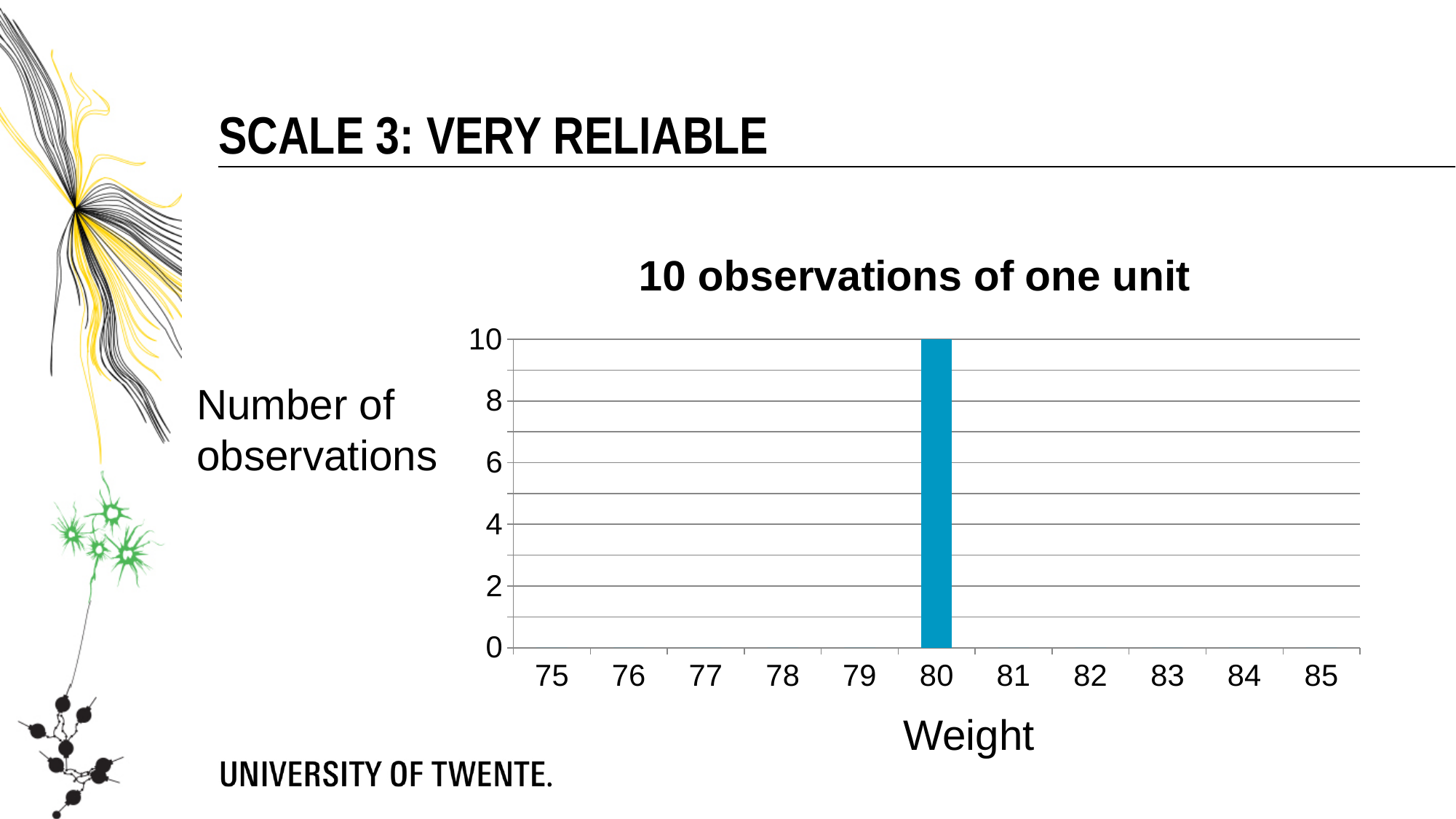
What is the difference between the number of observations at weight 80 and at weight 75? 10 Which weight has the highest number of observations? 80 What is the number of observations at weight 78? 0 What is the number of observations at weight 85? 0 What is the label of the x axis? Weight What is the number of observations at weight 80? 10 Which has more observations, weight 80 or weight 82? 80 What is the title of the chart? 10 observations of one unit Is the number of observations at weight 80 greater or less than 6? greater What is the highest value shown on the y axis? 10 How many weight categories are shown on the x axis? 11 What kind of chart is shown on the slide? bar chart